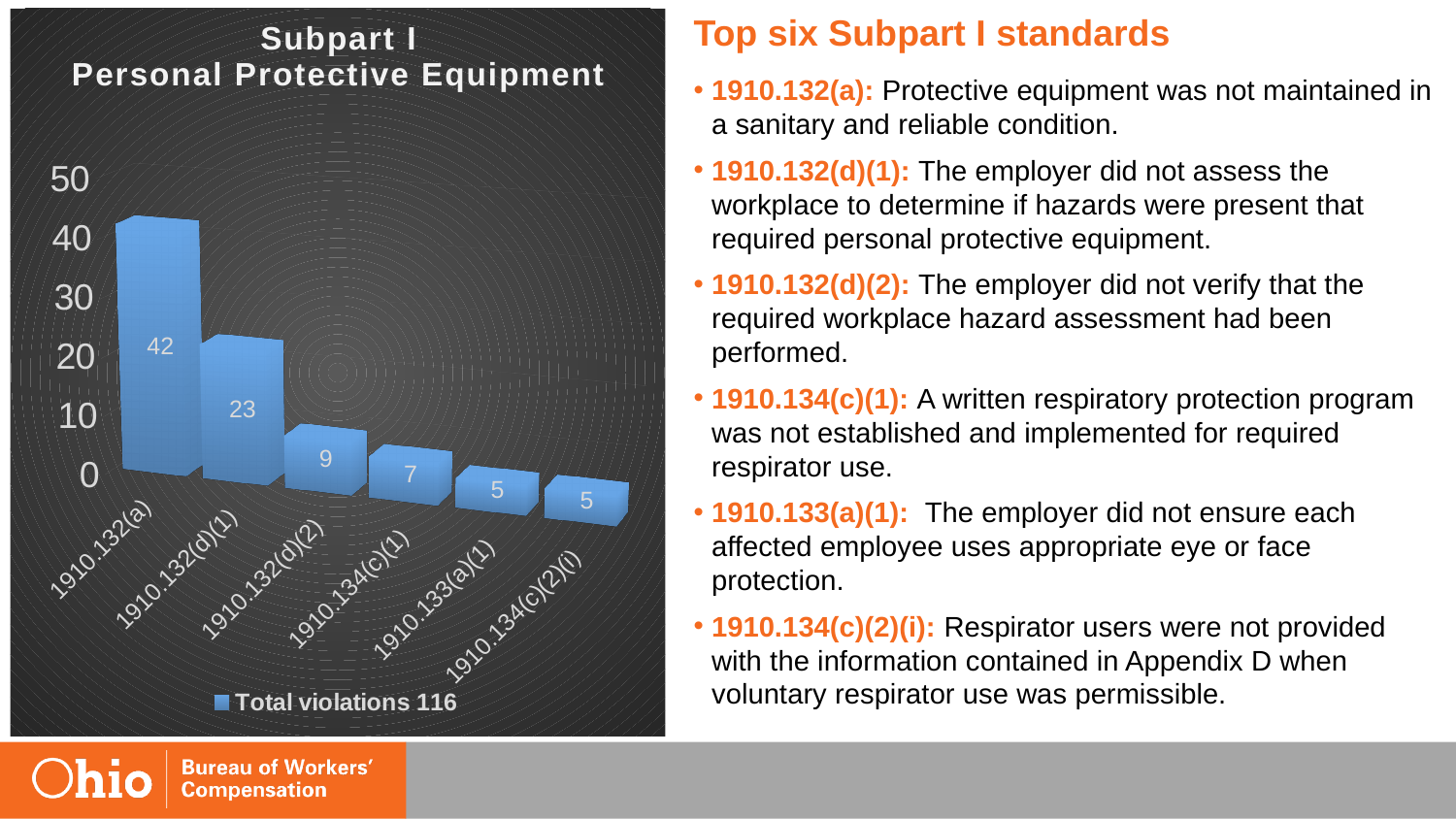
How many series does the legend list? 1 What kind of chart is shown? bar chart What is the value for 1910.134(c)(1)? 7 What is the legend entry of the chart? Total violations 116 What is the value for 1910.132(d)(1)? 23 What is the difference between the values for 1910.132(a) and 1910.132(d)(1)? 19 Which category has the highest value? 1910.132(a) Do the values rise or fall from left to right along the x axis? fall What is the value for 1910.132(a)? 42 Is the value for 1910.132(a) greater or less than 40? greater How many categories are shown on the chart? 6 Which is larger, the value for 1910.132(d)(2) or the value for 1910.133(a)(1)? 1910.132(d)(2)